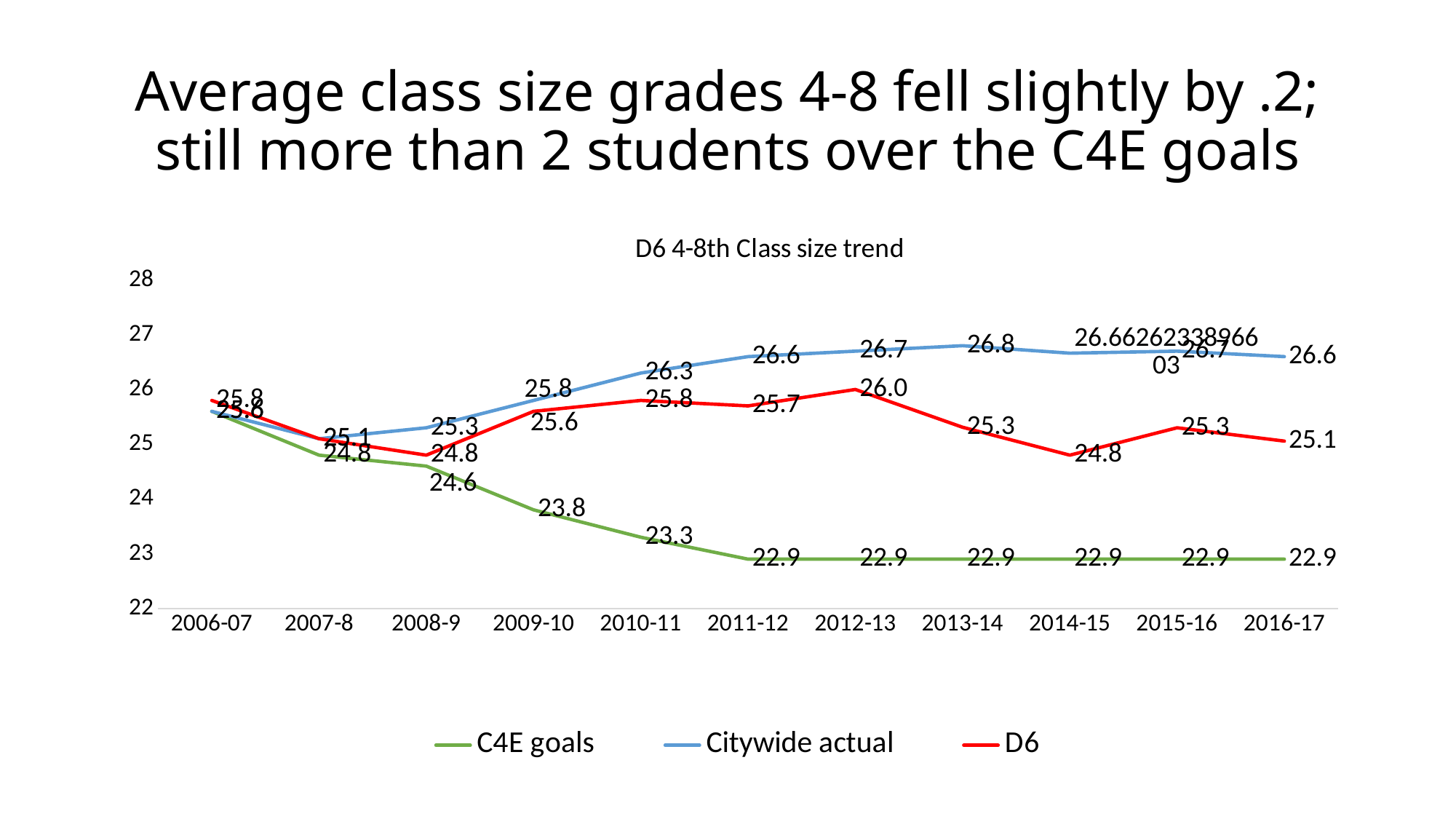
Which series has the higher value in 2016-17, Citywide actual or D6? Citywide actual What is the D6 value for 2016-17? 25.1 What is the difference between the Citywide actual and D6 values in 2016-17? 1.5 What is the D6 value for 2014-15? 24.8 What is the Citywide actual value for 2013-14? 26.8 What is the difference between the D6 and C4E goals values in 2016-17? 2.2 Do the C4E goals values rise or fall from 2006-07 to 2016-17? fall How many series does the legend list? 3 What is the C4E goals value for 2010-11? 23.3 What type of chart is shown on the slide? line chart How many school years are plotted along the x axis? 11 In which year does the D6 series reach its highest value? 2012-13